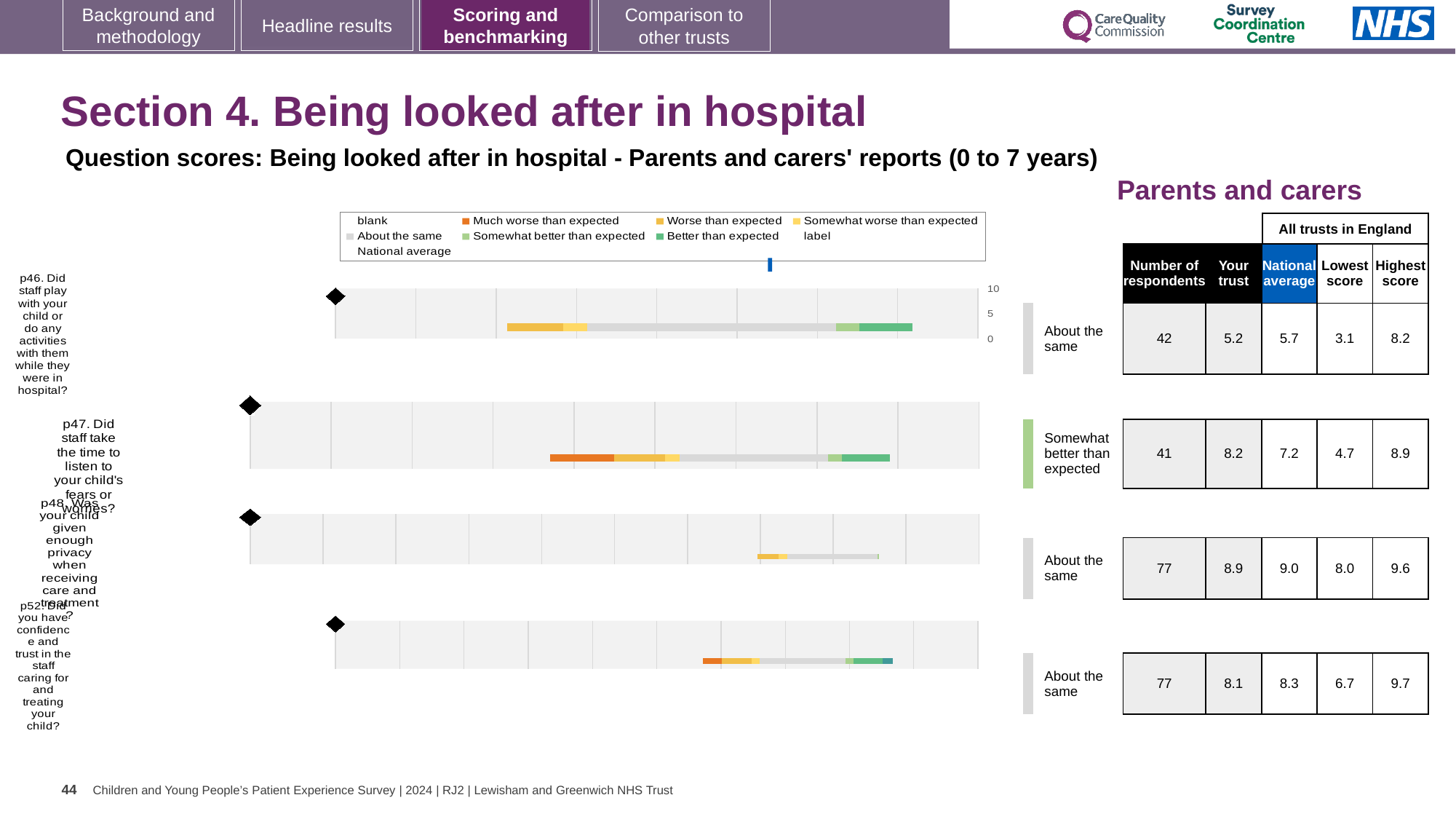
What kind of chart is used to show the results for question p46? bar chart Which question has the highest 'Your trust' score? p48 How many question charts are shown on the slide? 4 What benchmark category label is shown next to the p47 chart? Somewhat better than expected Which colour in the legend represents 'Much worse than expected'? orange For the p47 chart (staff taking time to listen to your child's fears or worries), what is the 'Your trust' score? 8.2 How many entries does the legend above the charts list? 9 For the p46 chart, what is the difference between the highest score and the lowest score across all trusts in England? 5.1 For the p46 chart (staff playing with your child), what is the national average score? 5.7 For the p47 chart, is the 'Your trust' score higher or lower than the national average? higher Which question has the lowest 'Your trust' score? p46 For the p48 chart (privacy when receiving care and treatment), how many respondents are there? 77